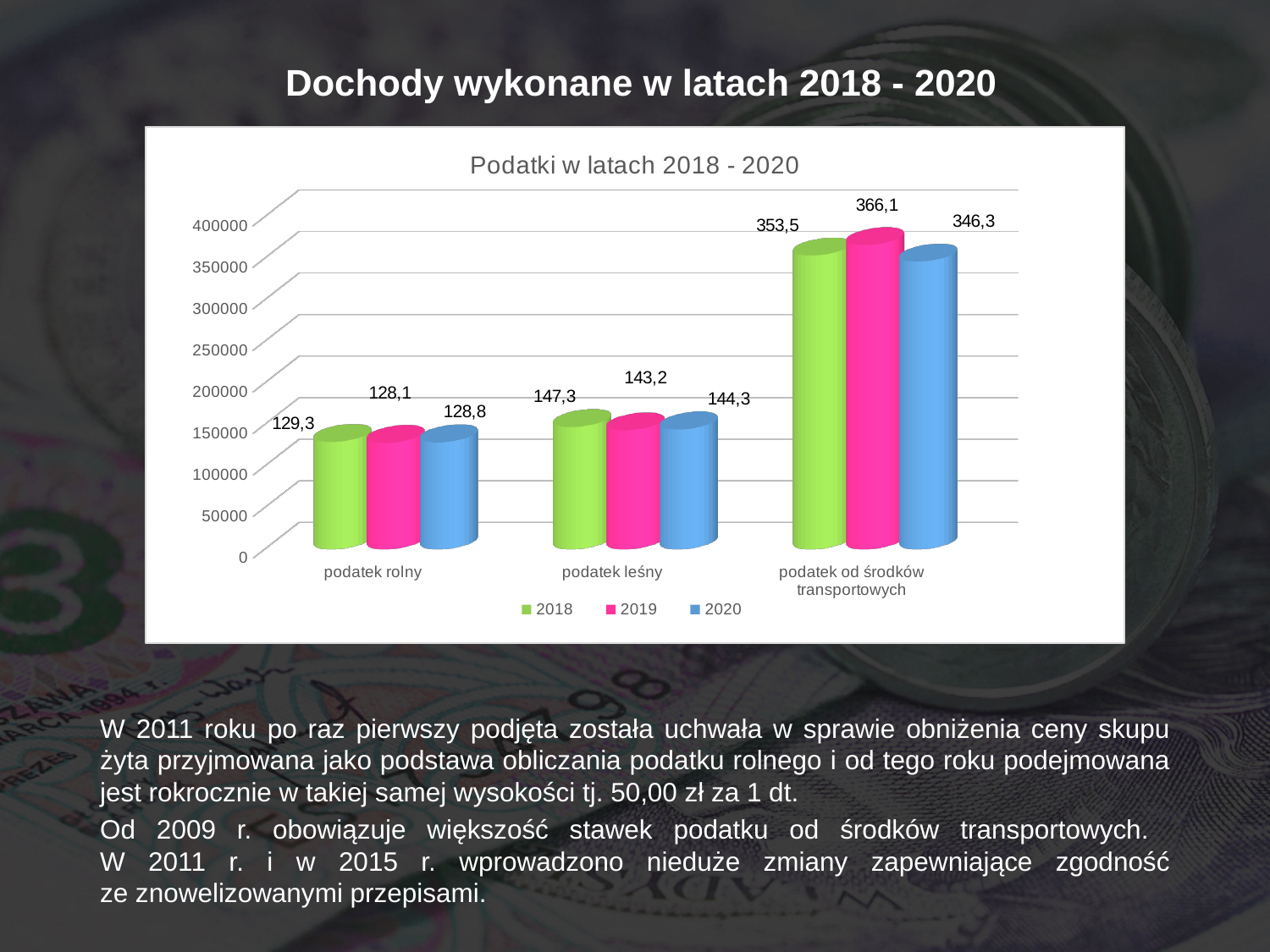
What is the value for podatek od środków transportowych in 2020? 346,3 How many series does the legend list? 3 Which is larger for podatek leśny: the 2018 value or the 2020 value? 2018 Which category has the lowest value in 2018? podatek rolny Is the 2020 bar for podatek od środków transportowych greater or less than 300000 on the axis? greater What is the difference between the 2019 and 2018 values for podatek od środków transportowych? 12,5 What type of chart is shown on the slide? bar chart What is the title of the chart? Podatki w latach 2018 - 2020 What is the value for podatek leśny in 2019? 143,2 Which category has the highest value in 2019? podatek od środków transportowych What is the value for podatek rolny in 2018? 129,3 How many categories are shown on the x axis? 3